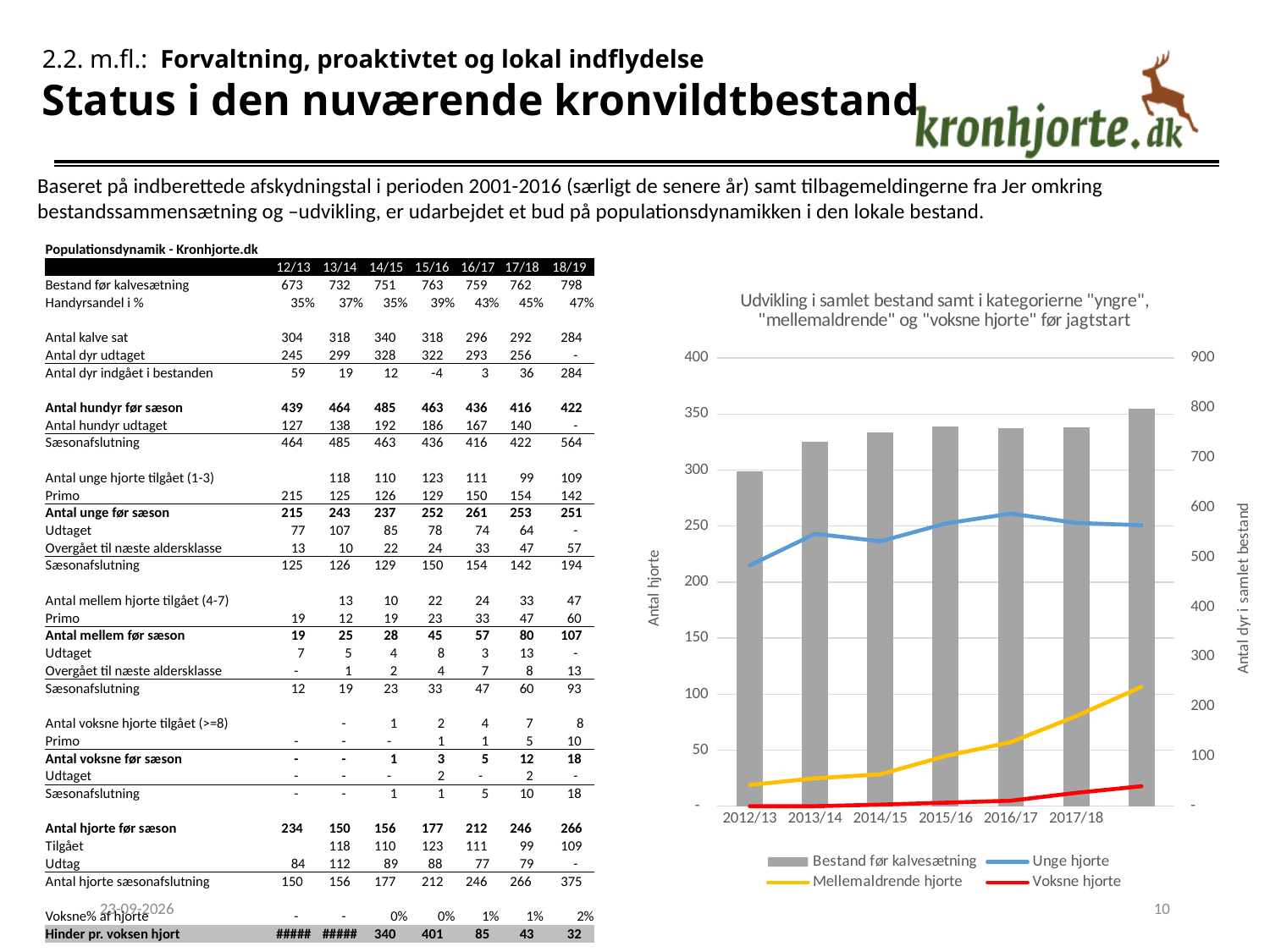
What kind of chart is shown on the slide? A combined bar and line chart Is the Bestand før kalvesætning bar for 2012/13 greater or less than 700 on the right axis? less Is the Bestand før kalvesætning bar for 2013/14 greater or less than 700 on the right axis? greater Is the value for Unge hjorte in 2012/13 greater or less than 250? less What is the label of the right-hand vertical axis of the chart? Antal dyr i samlet bestand Does the Mellemaldrende hjorte line rise or fall from 2012/13 to 2017/18? rise Which labelled year has the lowest bar for Bestand før kalvesætning? 2012/13 How many series does the chart legend list? 4 In 2015/16, which is larger: Unge hjorte or Mellemaldrende hjorte? Unge hjorte Which series in the chart is drawn as bars? Bestand før kalvesætning Which series has the lowest line across all years in the chart? Voksne hjorte